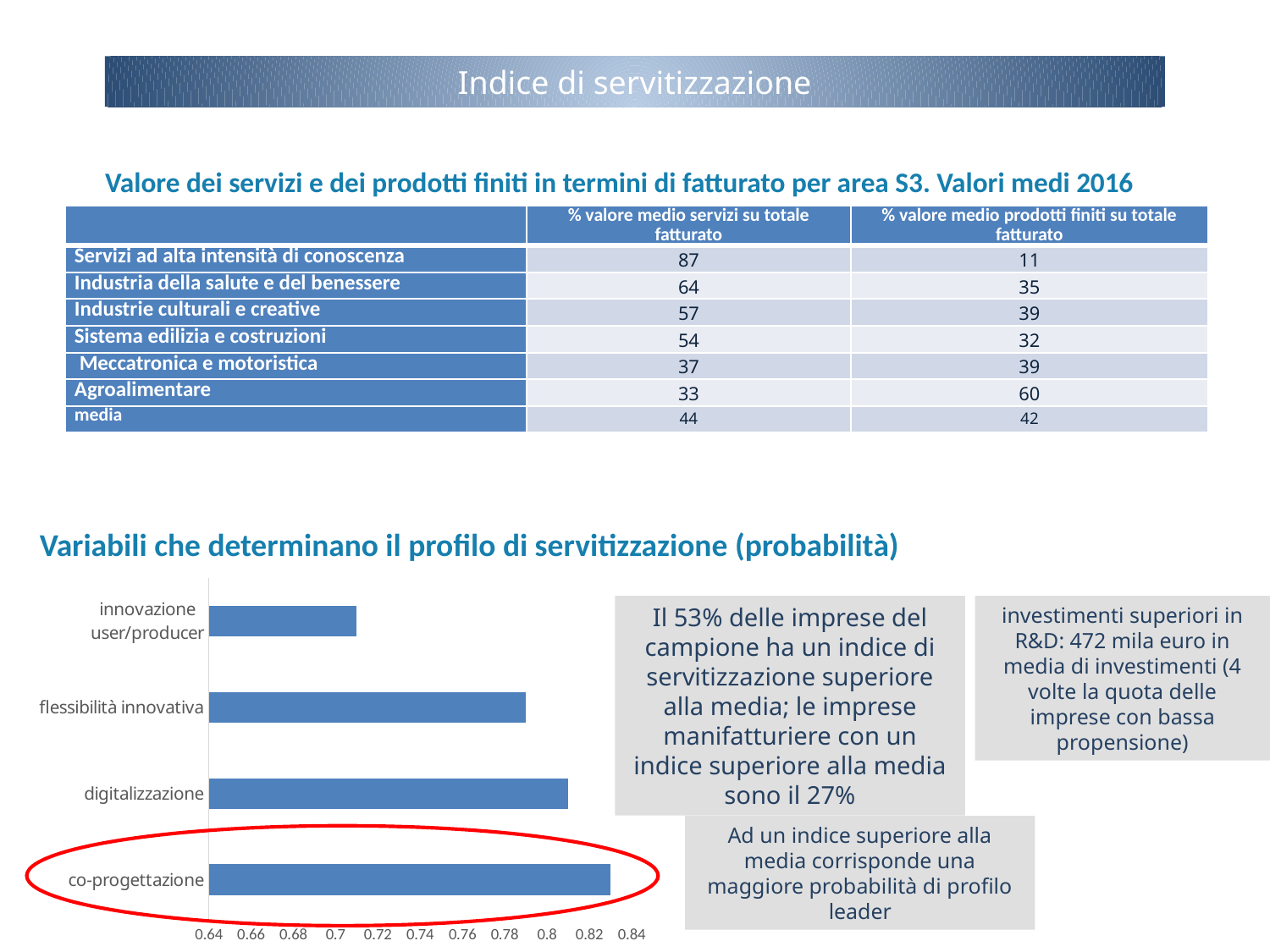
What kind of chart is shown at the bottom of the slide? bar chart In the bar chart, which is larger: digitalizzazione or flessibilità innovativa? digitalizzazione What is the title above the bar chart? Variabili che determinano il profilo di servitizzazione (probabilità) Which category has the lowest value in the bar chart? innovazione user/producer Is the value for digitalizzazione greater or less than 0.78? greater Is the value for flessibilità innovativa greater or less than 0.76? greater Which category in the bar chart is circled in red? co-progettazione Is the value for co-progettazione greater or less than 0.8? greater In the bar chart, which is larger: innovazione user/producer or co-progettazione? co-progettazione Which category has the highest value in the bar chart? co-progettazione How many categories does the bar chart show? 4